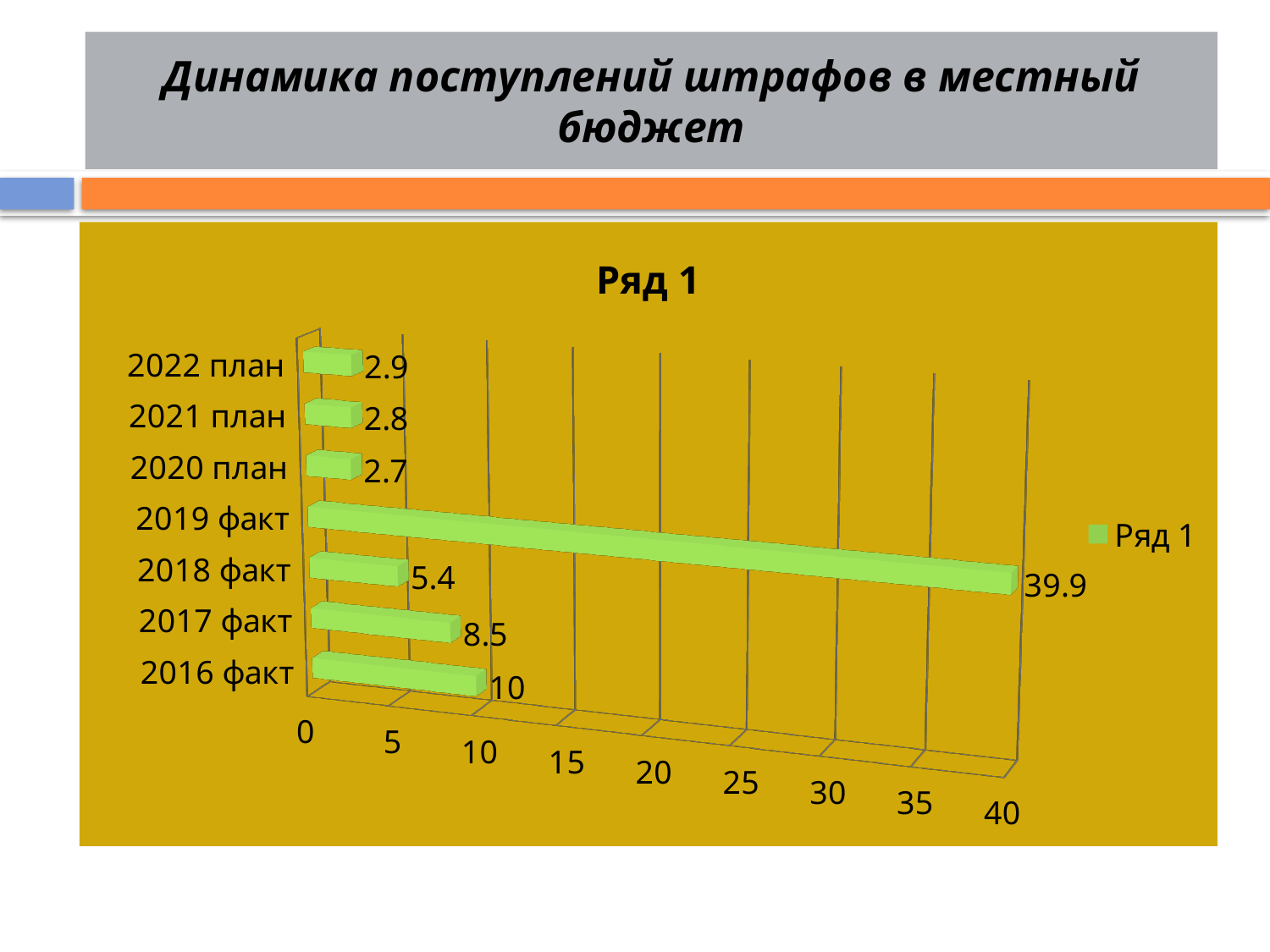
What is the value for 2016 факт? 10 What is the value for 2018 факт? 5.4 Which is larger, the value for 2016 факт or the value for 2017 факт? 2016 факт Which category has the lowest value? 2020 план What is the difference between the values for 2017 факт and 2018 факт? 3.1 What kind of chart is shown on the slide? bar chart How many categories are shown in the chart? 7 What is the value for 2022 план? 2.9 What is the title of the chart? Ряд 1 What is the value for 2019 факт? 39.9 Which category has the highest value? 2019 факт How many series does the legend list? 1